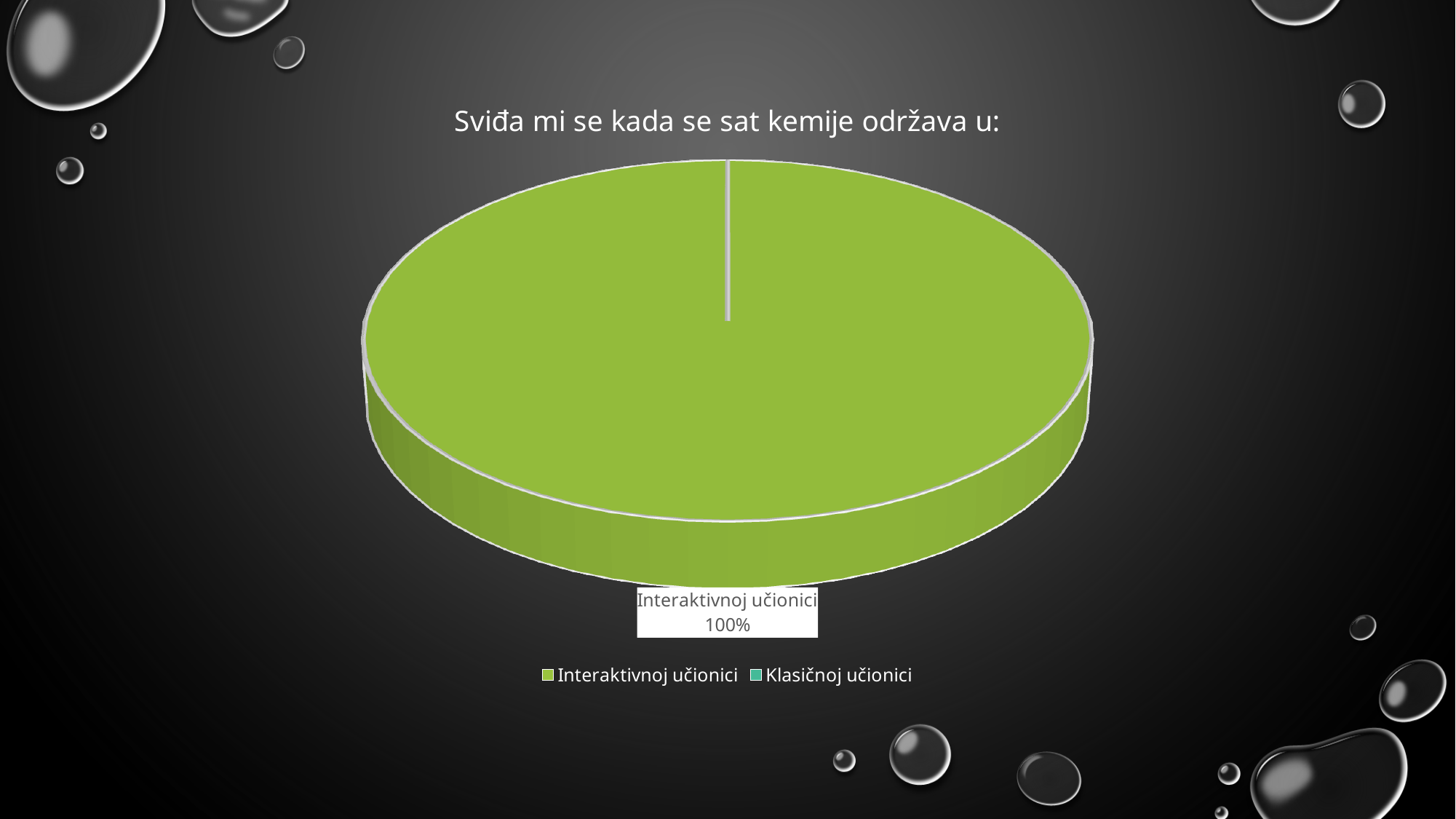
What kind of chart is shown on the slide? pie chart What share of the pie does "Interaktivnoj učionici" take? 100% How many entries does the legend list? 2 Is the share for "Interaktivnoj učionici" greater or less than 50%? greater What is the title of the chart? Sviđa mi se kada se sat kemije održava u: Which is larger, the share for "Interaktivnoj učionici" or the share for "Klasičnoj učionici"? Interaktivnoj učionici Which category has the smallest share of the pie? Klasičnoj učionici Which category has the largest share of the pie? Interaktivnoj učionici What colour is the slice for "Interaktivnoj učionici"? green